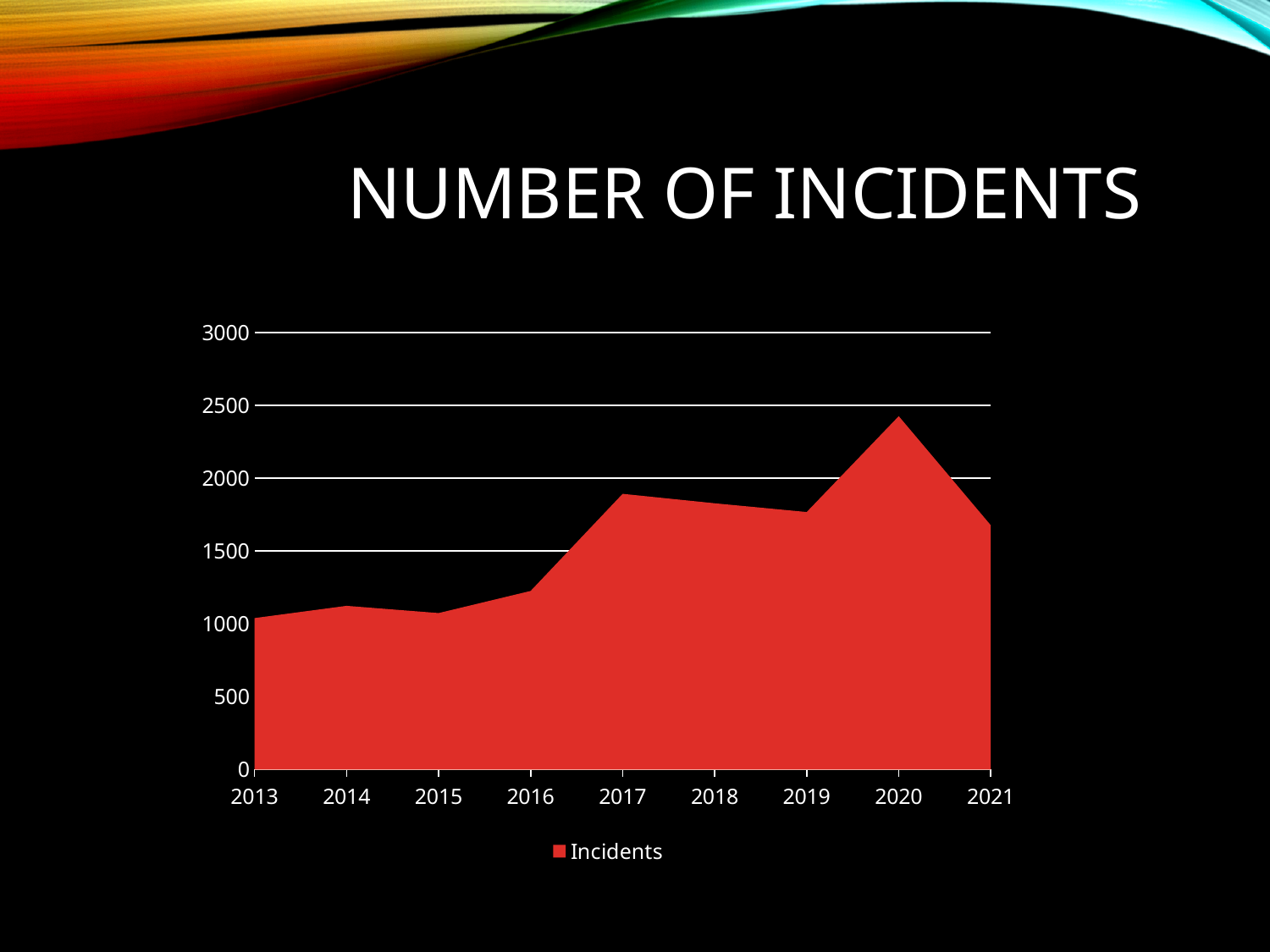
Is the value for 2017 greater or less than 2000? less What kind of chart is shown on the slide? Area chart Is the value for 2016 greater or less than 1500? less Which year has more incidents, 2020 or 2021? 2020 Is the value for 2020 greater or less than 2000? greater How many series does the legend list? 1 Do the values rise or fall from 2020 to 2021? fall What is the name of the series shown in the legend? Incidents Which year has the highest number of incidents? 2020 Which year has more incidents, 2016 or 2017? 2017 How many years are plotted along the x axis? 9